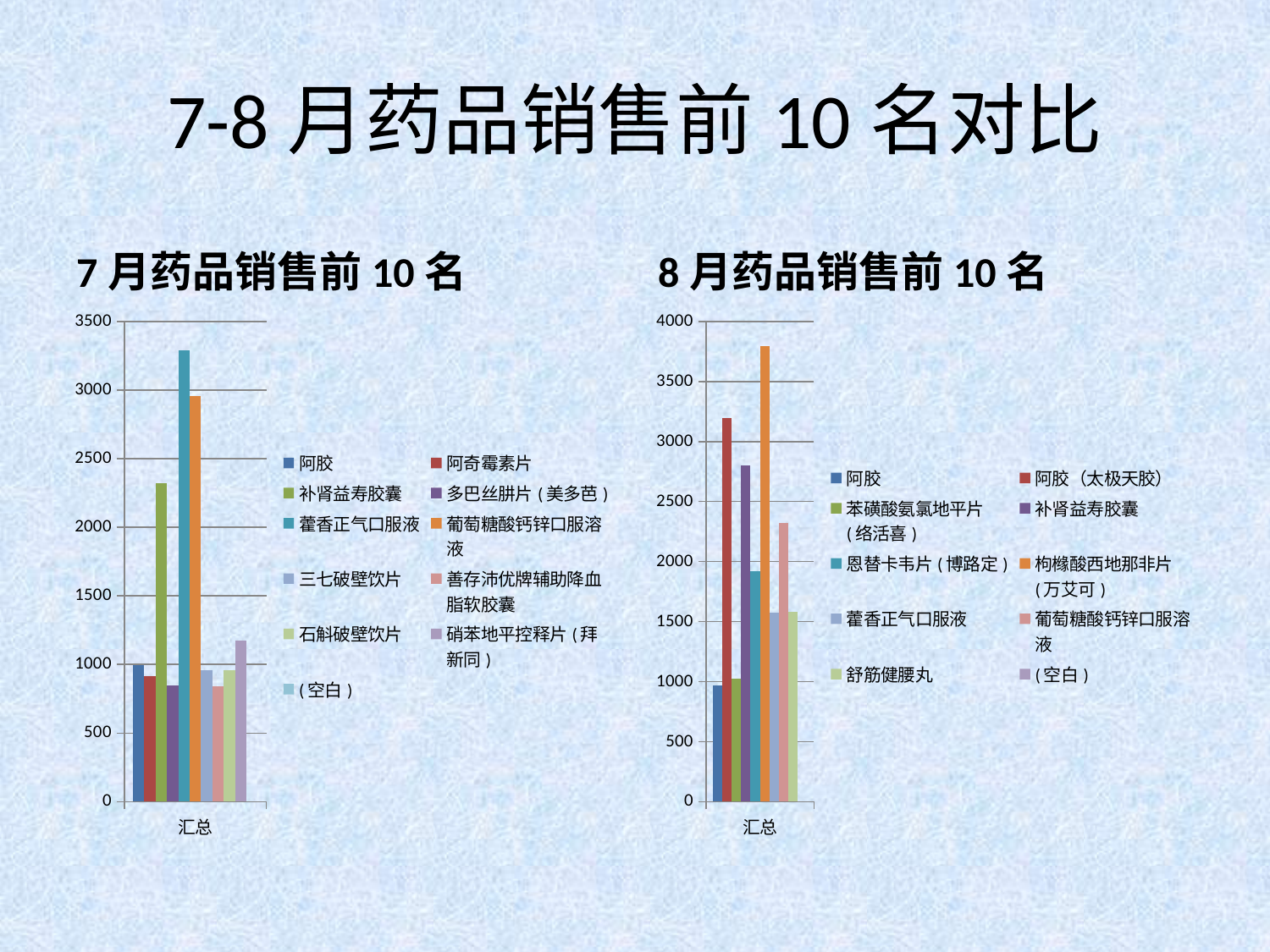
In the 7月药品销售前10名 chart, which is larger, 补肾益寿胶囊 or 葡萄糖酸钙锌口服溶液? 葡萄糖酸钙锌口服溶液 In the 8月药品销售前10名 chart, how many series does the legend list? 10 In the 8月药品销售前10名 chart, is the value for 阿胶（太极天胶） greater or less than 3000? greater In the 8月药品销售前10名 chart, is the value for 恩替卡韦片（博路定） greater or less than 2000? less In the 7月药品销售前10名 chart, how many series does the legend list? 11 In the 7月药品销售前10名 chart, which series has the highest bar? 藿香正气口服液 In the 7月药品销售前10名 chart, is the value for 补肾益寿胶囊 greater or less than 2000? greater What kind of chart is the 7月药品销售前10名 chart? bar chart In the 8月药品销售前10名 chart, which is larger, 阿胶（太极天胶） or 补肾益寿胶囊? 阿胶（太极天胶） What is the category label on the x axis of the 7月药品销售前10名 chart? 汇总 In the 8月药品销售前10名 chart, which series has the highest bar? 枸橼酸西地那非片（万艾可）